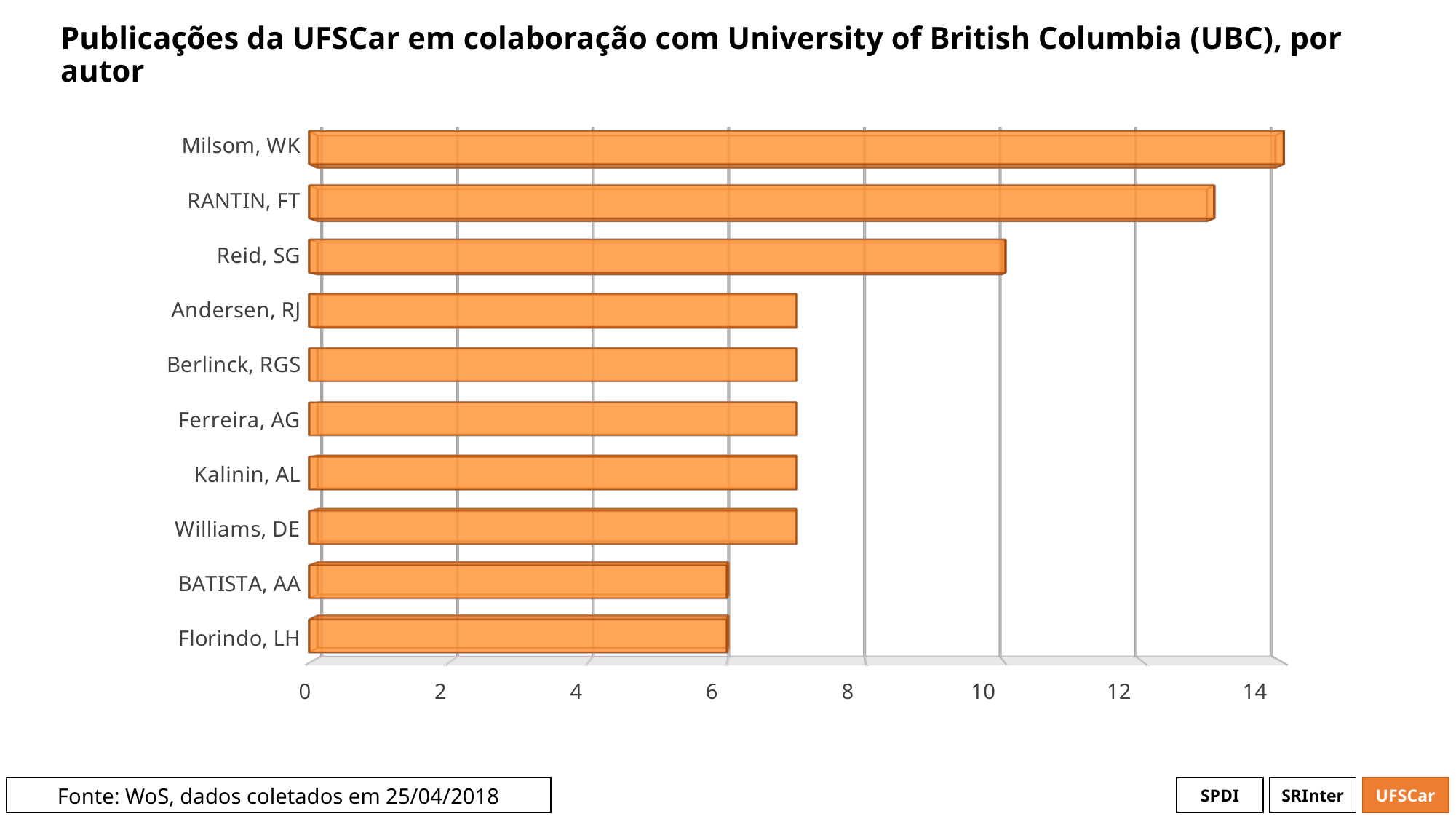
How many authors are listed in the chart? 10 Is the value for Florindo, LH greater or less than 8? less Is the value for RANTIN, FT greater or less than 12? greater Which has more publications, RANTIN, FT or Reid, SG? RANTIN, FT Is the value for Williams, DE greater or less than 8? less Which author has the highest number of publications? Milsom, WK What kind of chart is shown on the slide? bar chart Which has more publications, Milsom, WK or Kalinin, AL? Milsom, WK Which author is listed at the bottom of the chart? Florindo, LH What is the source of the data cited on the slide? WoS, dados coletados em 25/04/2018